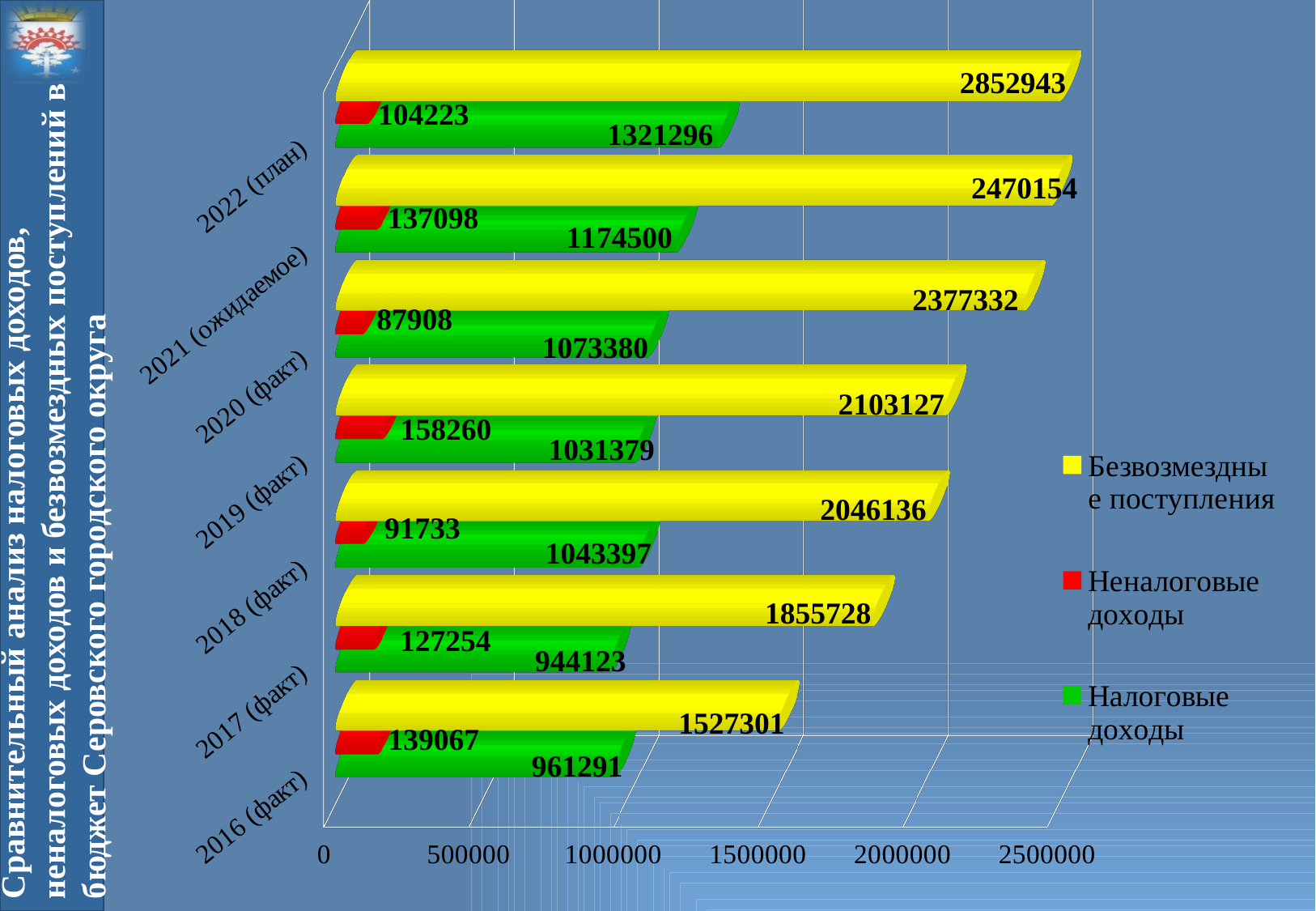
Which colour represents Налоговые доходы in the legend? green What is the value of Безвозмездные поступления for 2022 (план)? 2852943 Which category has the highest value of Неналоговые доходы? 2019 (факт) Which category has the lowest value of Безвозмездные поступления? 2016 (факт) What is the value of Налоговые доходы for 2019 (факт)? 1031379 How many series does the legend list? 3 What is the value of Неналоговые доходы for 2020 (факт)? 87908 What is the difference between Безвозмездные поступления for 2022 (план) and 2021 (ожидаемое)? 382789 How many categories (years) are shown on the chart? 7 What kind of chart is shown on the slide? bar chart Is the value of Безвозмездные поступления for 2018 (факт) greater or less than 2000000? greater Which is larger: Налоговые доходы for 2016 (факт) or for 2017 (факт)? 2016 (факт)